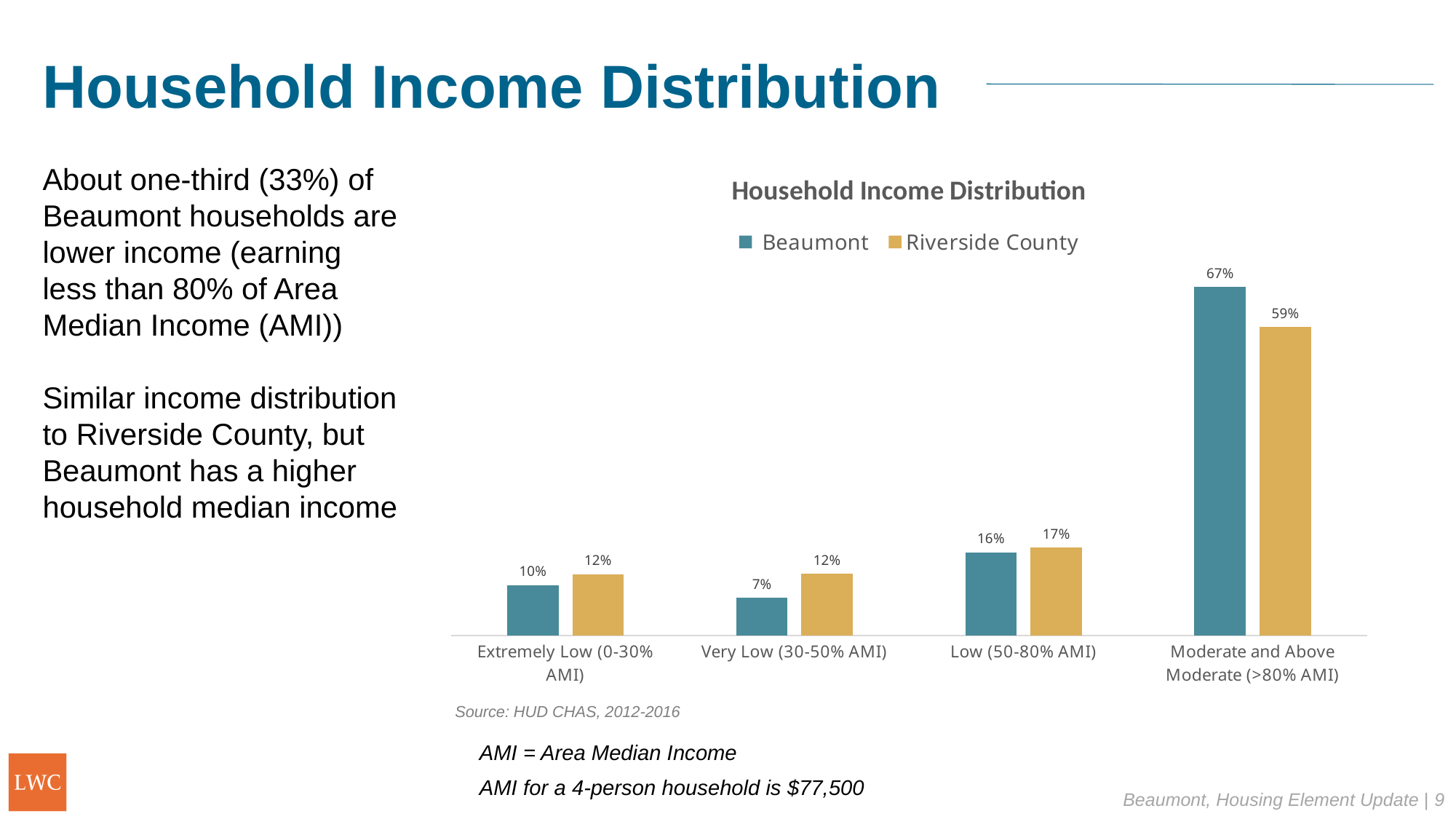
What is the difference between the Beaumont and Riverside County values for Moderate and Above Moderate (>80% AMI)? 8% What is the Beaumont value for Extremely Low (0-30% AMI)? 10% Which category has the lowest Beaumont value? Very Low (30-50% AMI) What is the Riverside County value for Low (50-80% AMI)? 17% For Very Low (30-50% AMI), which is larger: Beaumont or Riverside County? Riverside County How many series does the legend list? 2 What is the Riverside County value for Very Low (30-50% AMI)? 12% Which category has the highest Beaumont value? Moderate and Above Moderate (>80% AMI) What is the Beaumont value for Moderate and Above Moderate (>80% AMI)? 67% What is the title of the chart? Household Income Distribution What kind of chart is shown? Bar chart How many income categories are shown on the x axis? 4